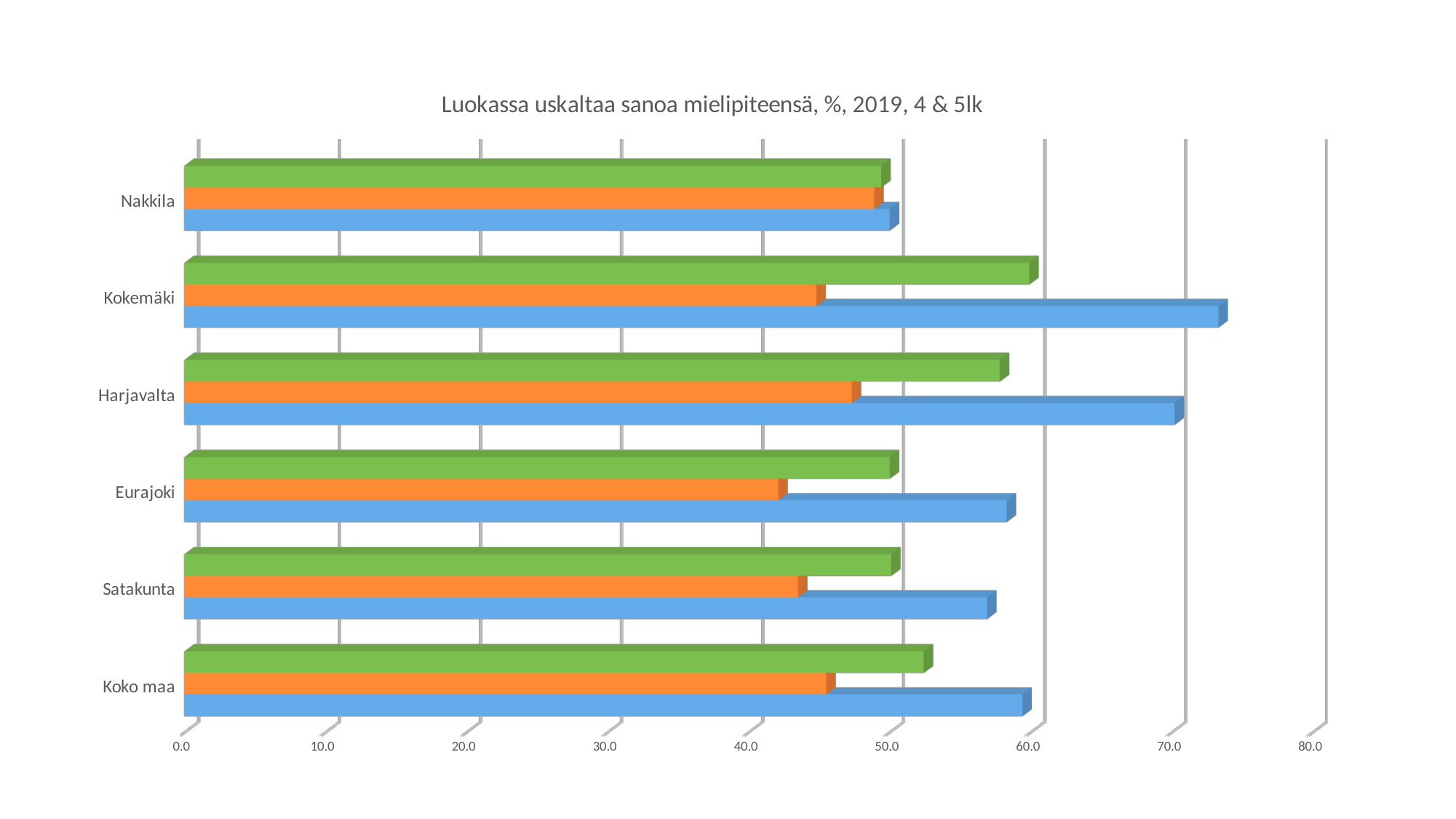
How many data series (bars per category) does the chart plot? 3 Is the orange bar for Eurajoki greater or less than 50? less Which category has the shortest blue bar? Nakkila For Harjavalta, which is larger, the blue bar or the green bar? the blue bar Which is larger, the blue bar for Kokemäki or the blue bar for Nakkila? Kokemäki Is the blue bar for Kokemäki greater or less than 70? greater Is the orange bar for Kokemäki greater or less than 50? less What is the title of the chart? Luokassa uskaltaa sanoa mielipiteensä, %, 2019, 4 & 5lk Which category has the longest blue bar? Kokemäki How many categories are shown on the vertical axis of the chart? 6 What kind of chart is shown on the slide? bar chart